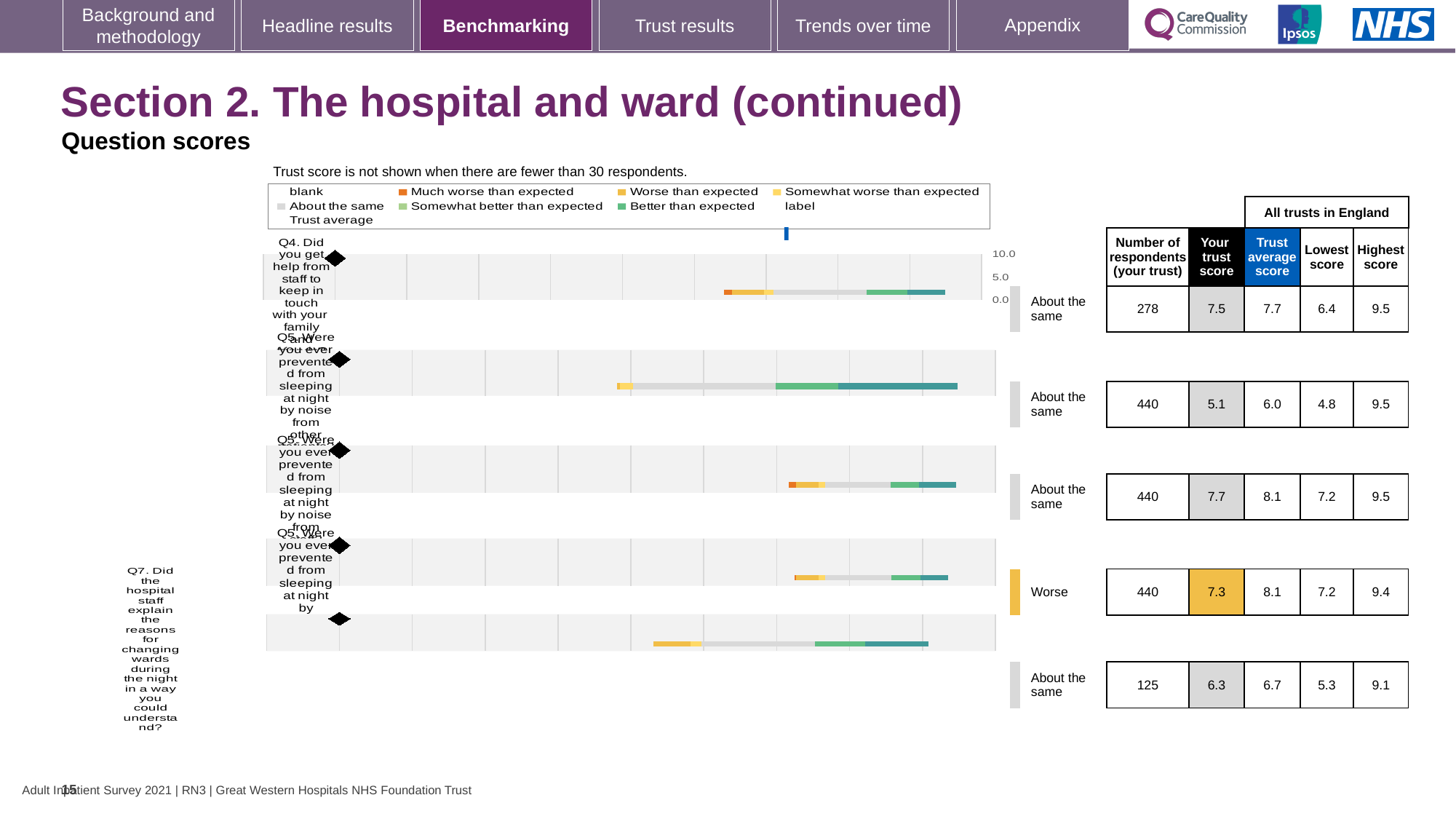
What is the 'Highest score' for the last row (Q7)? 9.1 What is the section title shown above the chart? Section 2. The hospital and ward (continued) How many respondents are listed for the last row (Q7, explaining reasons for changing wards during the night)? 125 For the fourth row (rated 'Worse'), what is the difference between the trust average score (8.1) and your trust score (7.3)? 0.8 What kind of chart is used to show the question scores on this slide? bar chart What is the largest number of respondents shown in the table? 440 How many question rows (bars) are shown in the benchmarking chart? 5 In the table next to the chart, what is the 'Your trust score' for the first row (Q4, help from staff to keep in touch with family)? 7.5 Which row of the chart is rated 'Worse' rather than 'About the same'? the fourth row What is the lowest 'Your trust score' shown in the table? 5.1 For the first row (Q4), which is larger: your trust score or the trust average score? Trust average score What is the 'Lowest score' for the second row of the table? 4.8